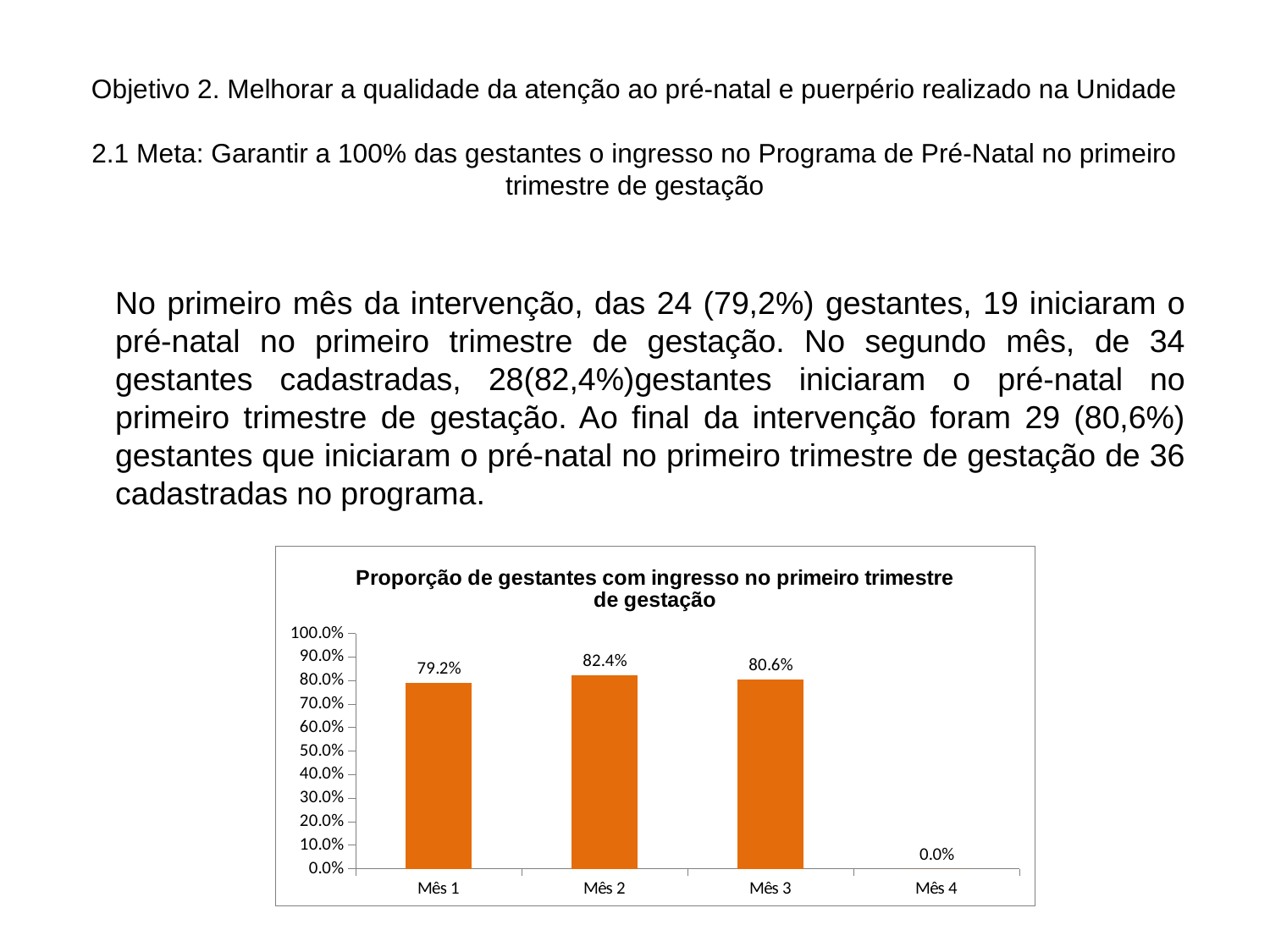
What is the value for Mês 2? 82.4% What is the difference between the values for Mês 2 and Mês 1? 3.2% What kind of chart is shown on the slide? bar chart How many months are shown on the x axis? 4 Is the value for Mês 1 greater or less than 70.0%? greater Which is larger, the value for Mês 2 or the value for Mês 3? Mês 2 Which month has the lowest value? Mês 4 What is the value for Mês 4? 0.0% What is the value for Mês 1? 79.2% What is the title of the chart? Proporção de gestantes com ingresso no primeiro trimestre de gestação Which month has the highest value? Mês 2 What is the value for Mês 3? 80.6%